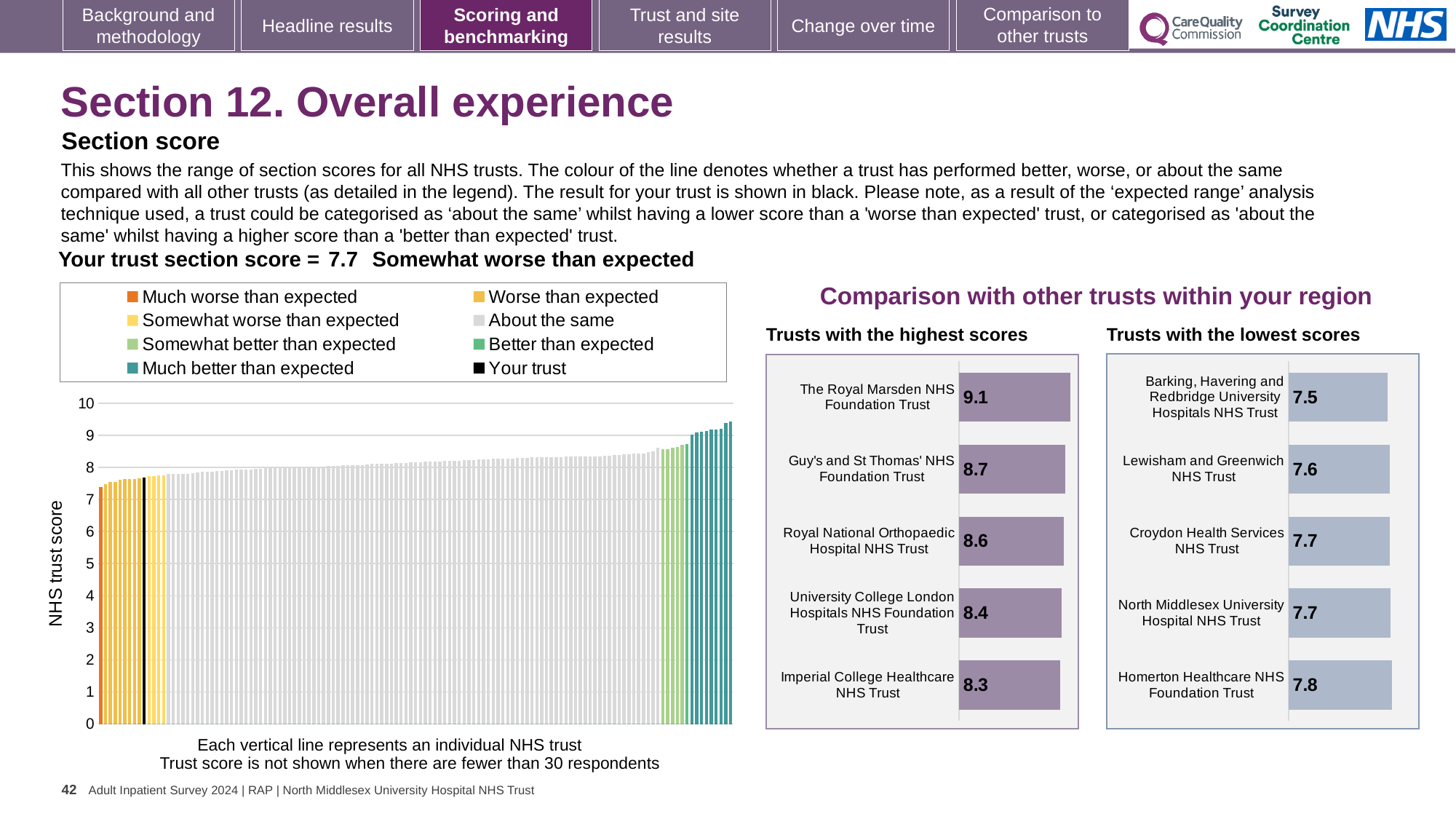
In the 'Trusts with the lowest scores' chart, what is the score for Barking, Havering and Redbridge University Hospitals NHS Trust? 7.5 How many entries does the legend of the main 'NHS trust score' chart on the left list? 8 In the 'Trusts with the highest scores' chart, what is the difference between the scores of The Royal Marsden NHS Foundation Trust and Guy's and St Thomas' NHS Foundation Trust? 0.4 In the 'Trusts with the lowest scores' chart, which has the higher score: Lewisham and Greenwich NHS Trust or Homerton Healthcare NHS Foundation Trust? Homerton Healthcare NHS Foundation Trust In the main 'NHS trust score' chart on the left, what is the section score for your trust? 7.7 In the 'Trusts with the lowest scores' chart, what is the score for Homerton Healthcare NHS Foundation Trust? 7.8 In the 'Trusts with the highest scores' chart, what is the score for Imperial College Healthcare NHS Trust? 8.3 In the 'Trusts with the lowest scores' chart, which trust has the lowest score? Barking, Havering and Redbridge University Hospitals NHS Trust How many trusts are shown in the 'Trusts with the highest scores' chart? 5 In the 'Trusts with the highest scores' chart, what is the score for The Royal Marsden NHS Foundation Trust? 9.1 In the main 'NHS trust score' chart on the left, do the values rise or fall from left to right? rise In the 'Trusts with the highest scores' chart, which trust has the highest score? The Royal Marsden NHS Foundation Trust